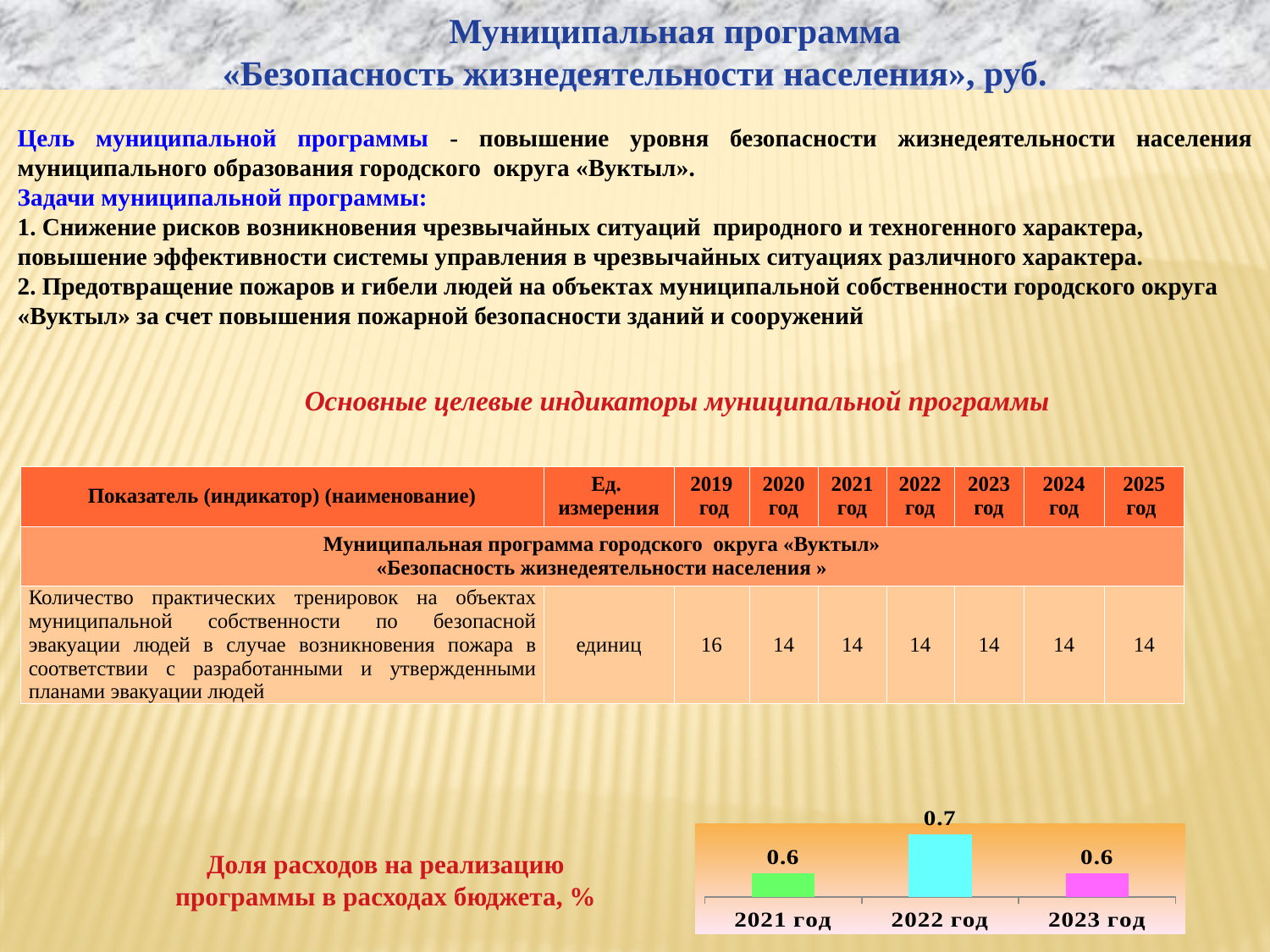
What colour is the bar for 2022 год in the bar chart? cyan What kind of chart is shown at the bottom of the slide? bar chart Does the value in the bar chart rise or fall from 2022 год to 2023 год? fall Which year has the highest value in the bar chart? 2022 год What does the text to the left of the bar chart say the chart shows? Доля расходов на реализацию программы в расходах бюджета, % What is the value for 2023 год in the bar chart? 0.6 What is the difference between the values for 2022 год and 2021 год in the bar chart? 0.1 What is the value for 2021 год in the bar chart? 0.6 How many bars are shown in the bar chart? 3 What is the total of the three values shown in the bar chart? 1.9 Which is larger in the bar chart, the value for 2022 год or the value for 2023 год? 2022 год What is the value for 2022 год in the bar chart? 0.7